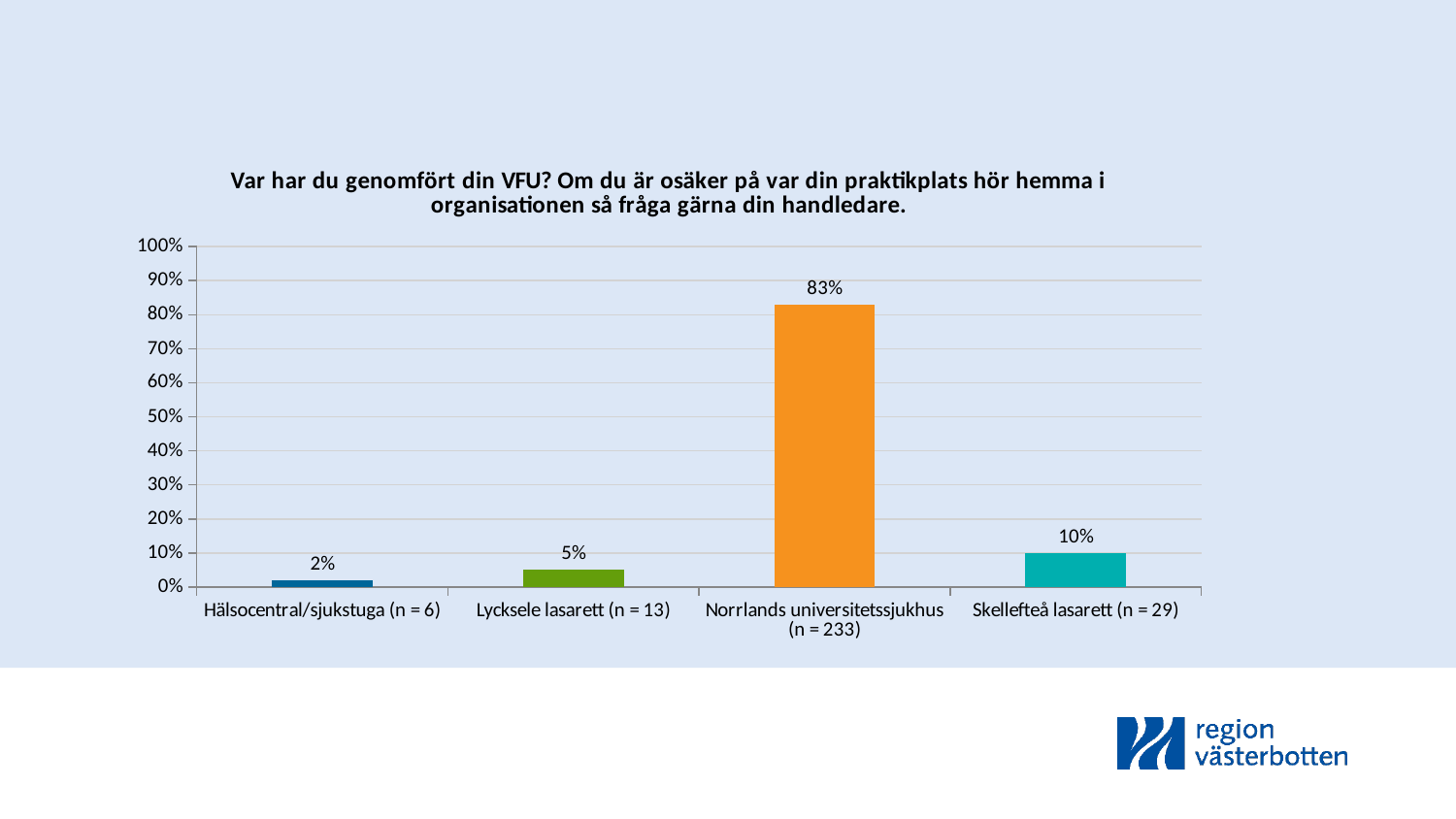
What is the value for Lycksele lasarett (n = 13)? 5% What is the difference between the values for Lycksele lasarett and Hälsocentral/sjukstuga? 3% What is the value for Norrlands universitetssjukhus (n = 233)? 83% What is the value for Hälsocentral/sjukstuga (n = 6)? 2% How many categories are shown on the x axis? 4 Which category has the lowest value? Hälsocentral/sjukstuga (n = 6) Which is larger, the value for Skellefteå lasarett or the value for Lycksele lasarett? Skellefteå lasarett Which category has the highest value? Norrlands universitetssjukhus (n = 233) Is the value for Norrlands universitetssjukhus greater or less than 80%? greater What is the difference between the values for Norrlands universitetssjukhus and Skellefteå lasarett? 73% What is the value for Skellefteå lasarett (n = 29)? 10% What kind of chart is shown on the slide? bar chart